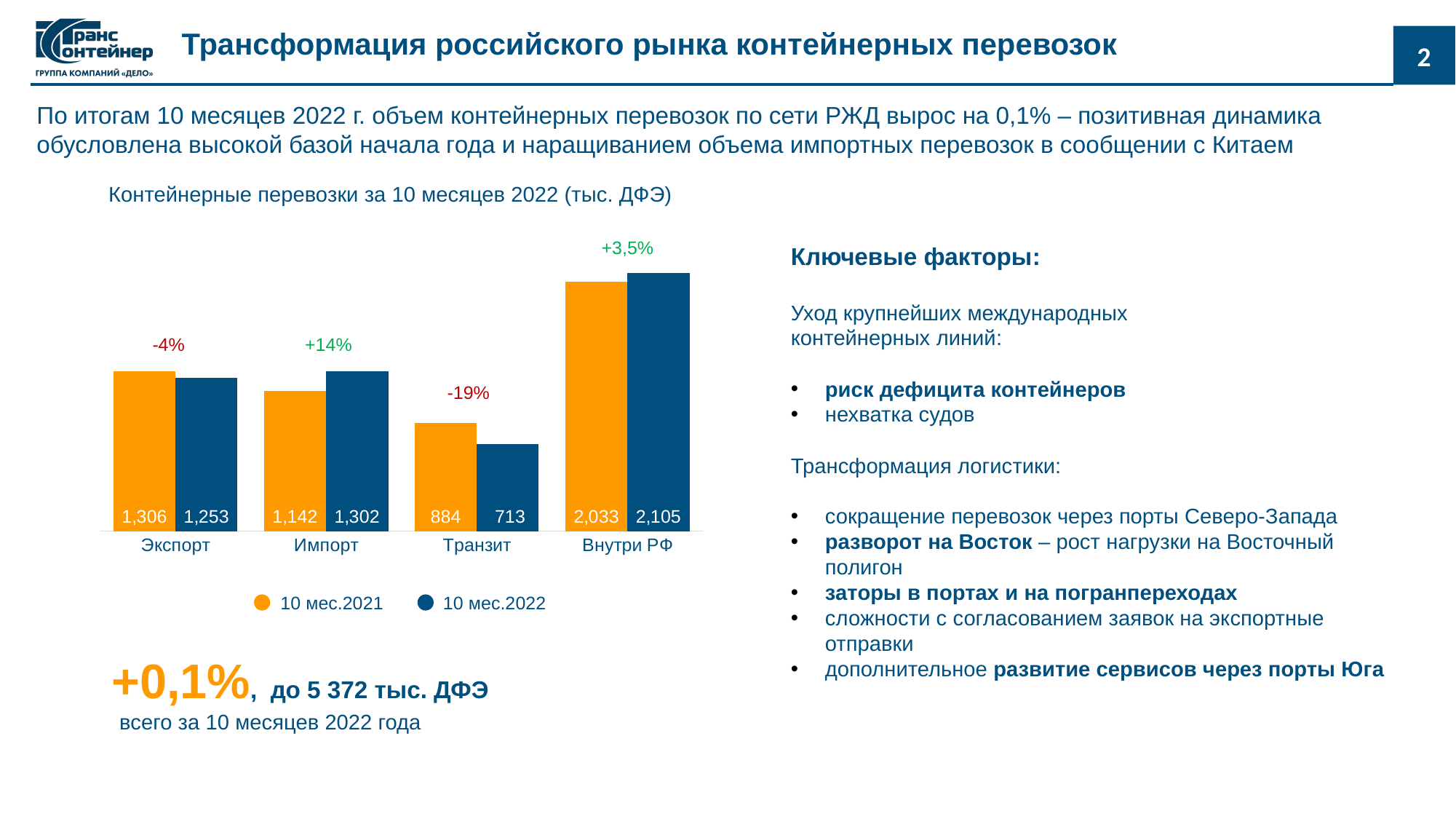
What is the value for Транзит in the 10 мес.2022 series? 713 How many series does the chart legend list? 2 Which category has the highest value in the 10 мес.2022 series? Внутри РФ What kind of chart is shown on the slide? Bar chart What percentage change is shown above the Транзит bars? -19% What is the title of the chart? Контейнерные перевозки за 10 месяцев 2022 (тыс. ДФЭ) Which is larger for Импорт: the 10 мес.2021 value or the 10 мес.2022 value? 10 мес.2022 How many categories are shown on the x axis of the chart? 4 What is the value for Экспорт in the 10 мес.2021 series? 1,306 Which category has the lowest value in the 10 мес.2021 series? Транзит What is the difference between the 10 мес.2022 and 10 мес.2021 values for Внутри РФ? 72 What is the value for Импорт in the 10 мес.2022 series? 1,302